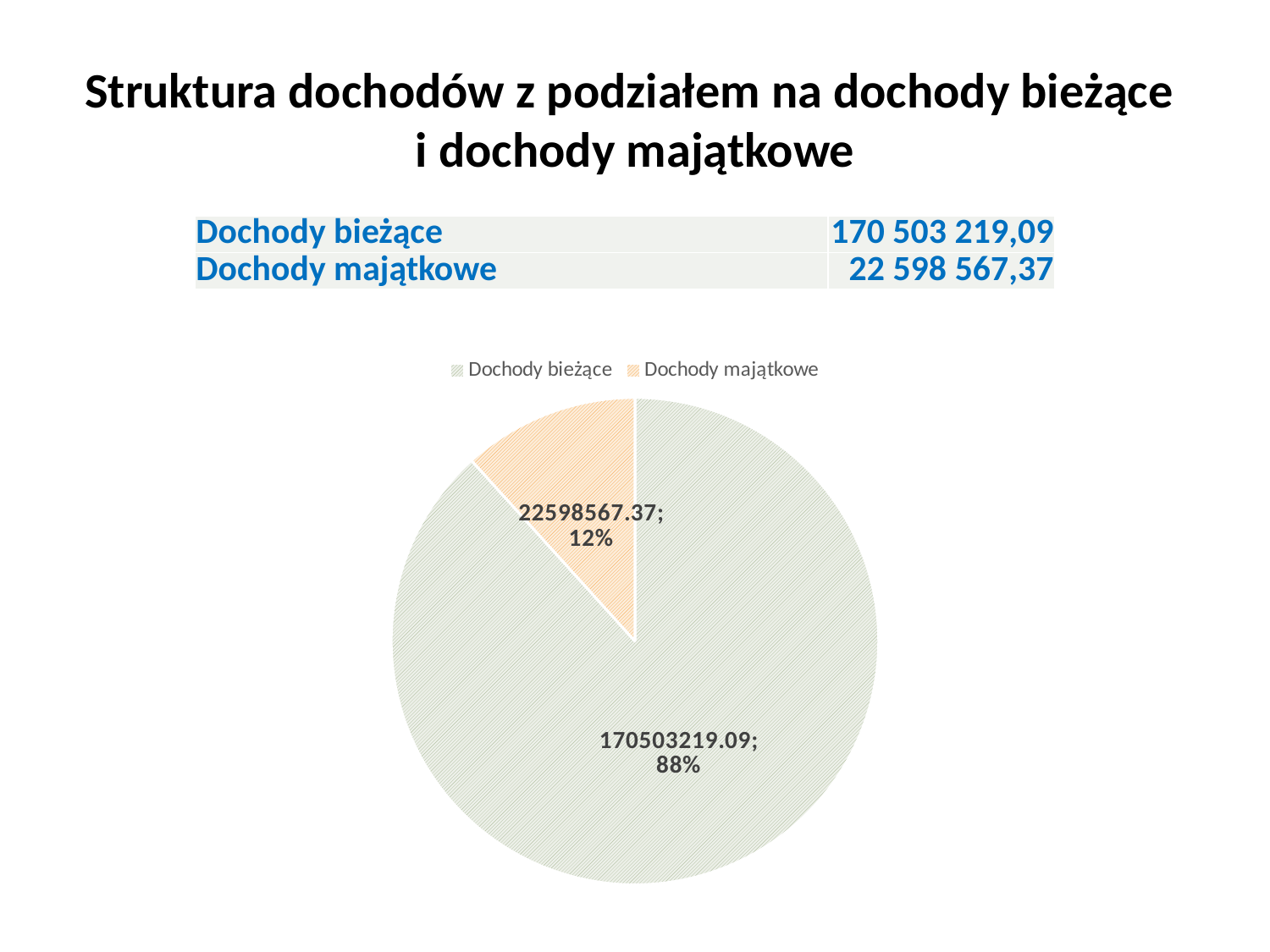
Which legend entry is shown in orange in the pie chart? Dochody majątkowe What share of the pie does Dochody bieżące represent? 88% Which slice of the pie chart is the smallest? Dochody majątkowe What value is labelled on the Dochody majątkowe slice of the pie chart? 22598567.37 How many slices does the pie chart have? 2 What share of the pie does Dochody majątkowe represent? 12% Which is larger, Dochody bieżące or Dochody majątkowe? Dochody bieżące What kind of chart is shown on the slide? pie chart How many entries does the legend of the pie chart list? 2 Which slice of the pie chart is the largest? Dochody bieżące What value is labelled on the Dochody bieżące slice of the pie chart? 170503219.09 What is the difference in percentage points between the Dochody bieżące share and the Dochody majątkowe share? 76